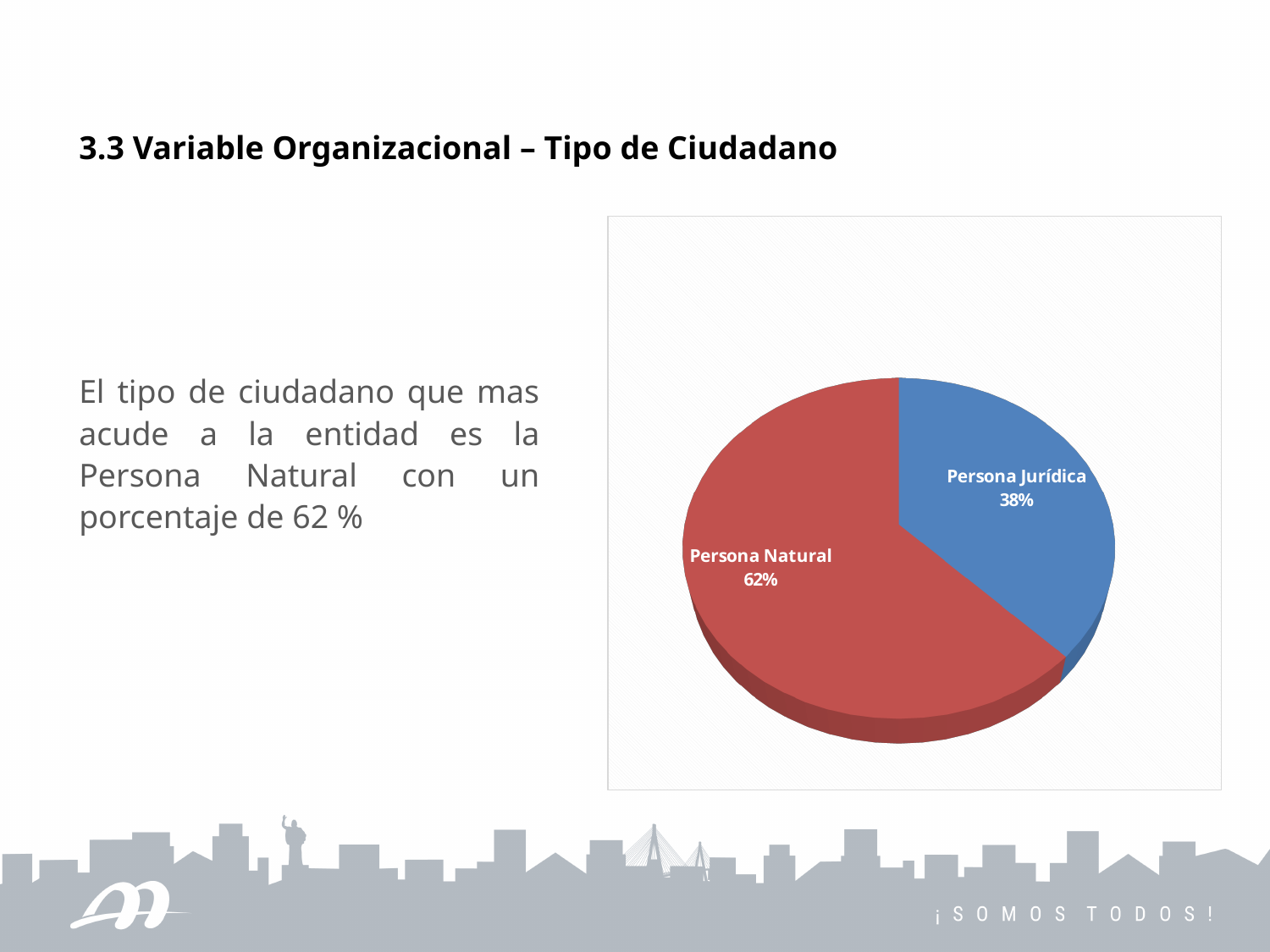
Which is larger, the share for Persona Natural or the share for Persona Jurídica? Persona Natural What percentage does the Persona Natural slice represent? 62% What share of the pie does Persona Jurídica take? 38% What is the difference in percentage points between Persona Natural and Persona Jurídica? 24 What percentage does the Persona Jurídica slice represent? 38% How many slices does the pie chart have? 2 Which category has the largest share of the pie? Persona Natural What kind of chart is shown on the slide? Pie chart What colour is the Persona Jurídica slice? Blue What colour is the Persona Natural slice? Red Which category has the smallest share of the pie? Persona Jurídica